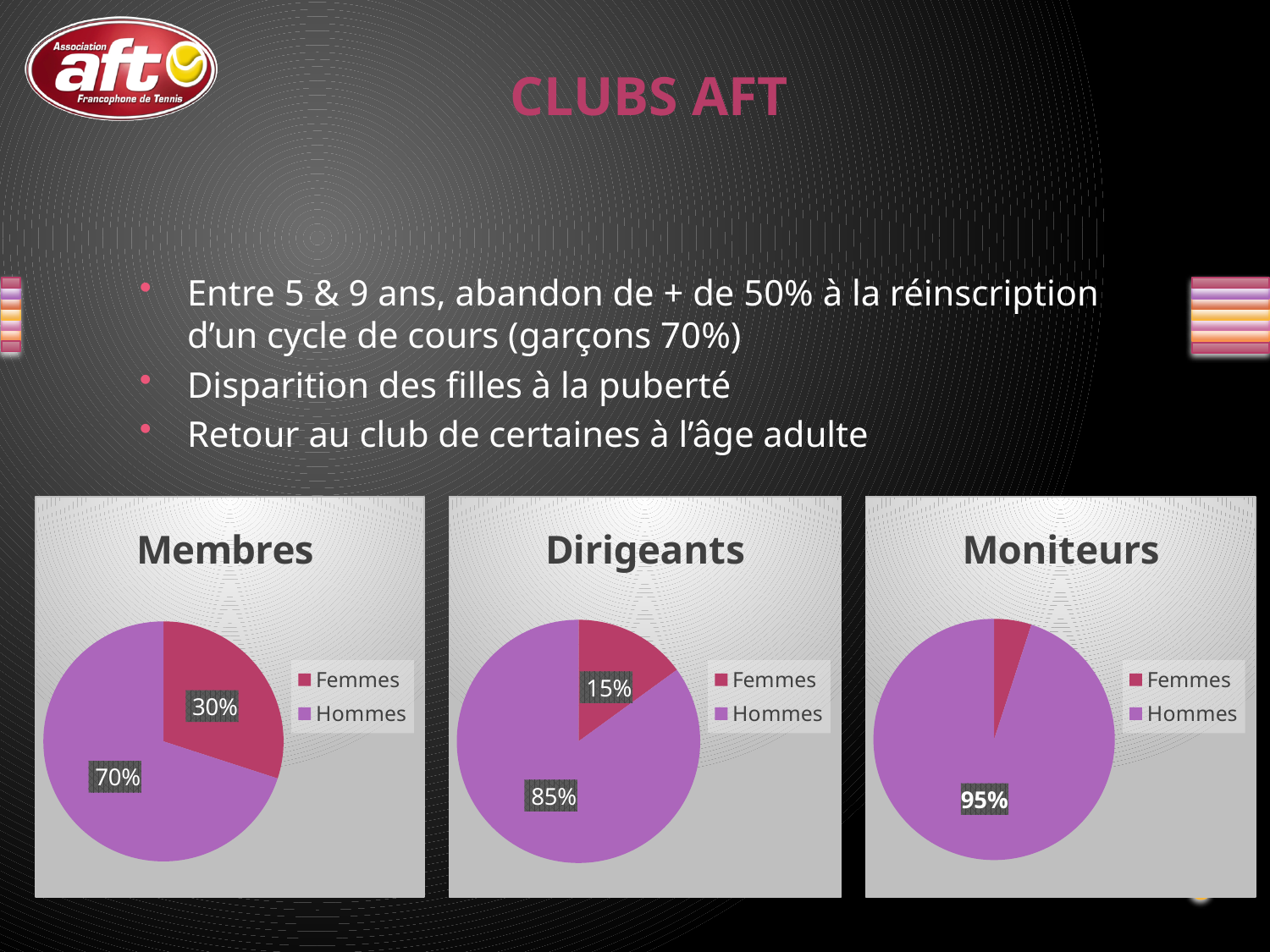
In the "Membres" chart, what percentage is shown for Femmes? 30% In the "Moniteurs" chart, what percentage is shown for Hommes? 95% In the "Dirigeants" chart, what percentage is shown for Femmes? 15% In the "Membres" chart, what is the difference between the Hommes and Femmes shares? 40% In the "Membres" chart, what percentage is shown for Hommes? 70% What type of chart is the "Membres" chart? Pie chart What is the title of the chart on the right of the slide? Moniteurs In the "Moniteurs" chart, which slice is larger, Femmes or Hommes? Hommes In the "Dirigeants" chart, which category has the smallest slice? Femmes In the "Dirigeants" chart, what percentage is shown for Hommes? 85% In the "Dirigeants" chart, what is the difference between the Hommes and Femmes shares? 70% How many entries does the legend of the "Moniteurs" chart list? 2